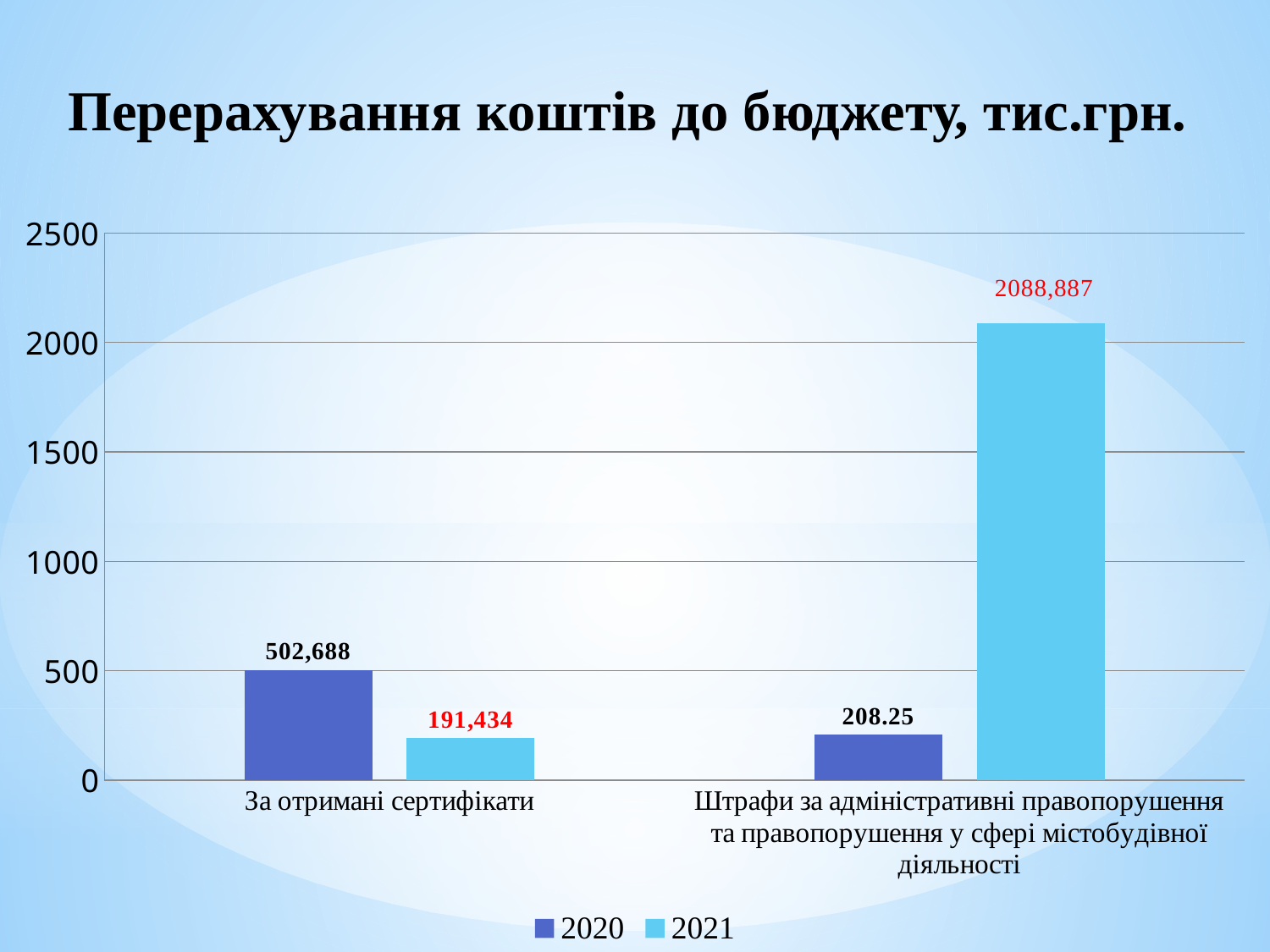
What is the 2021 value for "За отримані сертифікати"? 191,434 How many series does the legend list? 2 Which bar has the highest value in the chart? 2021, Штрафи за адміністративні правопорушення та правопорушення у сфері містобудівної діяльності What is the difference between the 2020 and 2021 values for "За отримані сертифікати"? 311,254 What is the 2020 value for "Штрафи за адміністративні правопорушення та правопорушення у сфері містобудівної діяльності"? 208.25 What is the title of the chart? Перерахування коштів до бюджету, тис.грн. What is the 2020 value for "За отримані сертифікати"? 502,688 Is the 2021 value for "Штрафи за адміністративні правопорушення та правопорушення у сфері містобудівної діяльності" greater or less than 2000? greater Which series has the larger value for "За отримані сертифікати", 2020 or 2021? 2020 What is the 2021 value for "Штрафи за адміністративні правопорушення та правопорушення у сфері містобудівної діяльності"? 2088,887 What type of chart is shown on the slide? bar chart How many categories are shown on the x axis? 2